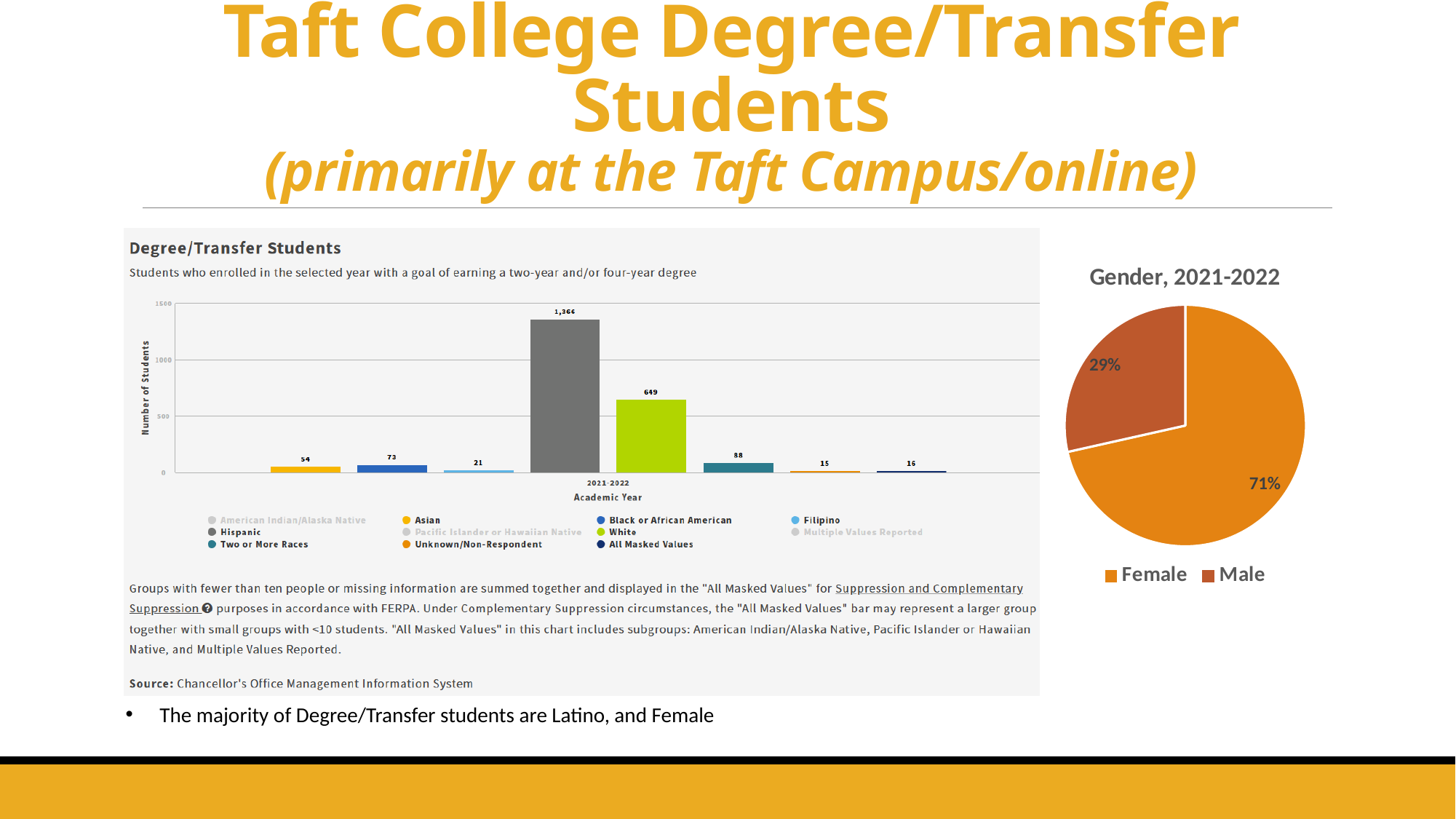
In the Degree/Transfer Students bar chart, how many students are Hispanic? 1,366 In the Degree/Transfer Students bar chart, which group has the lowest number of students? Unknown/Non-Respondent What kind of chart is the Degree/Transfer Students chart? Bar chart In the Degree/Transfer Students bar chart, what is the value for White students? 649 In the Degree/Transfer Students bar chart, how many bars are plotted? 8 In the Gender, 2021-2022 pie chart, what is the value for Male? 29% In the Degree/Transfer Students bar chart, which is larger, the value for Asian or for Black or African American? Black or African American In the Degree/Transfer Students bar chart, what is the difference between the Hispanic and White values? 717 In the Degree/Transfer Students bar chart, which group has the highest number of students? Hispanic In the Gender, 2021-2022 pie chart, what share is Female? 71% In the Degree/Transfer Students bar chart, is the value for White greater or less than 500? greater In the Degree/Transfer Students bar chart, what is the value for Two or More Races? 88